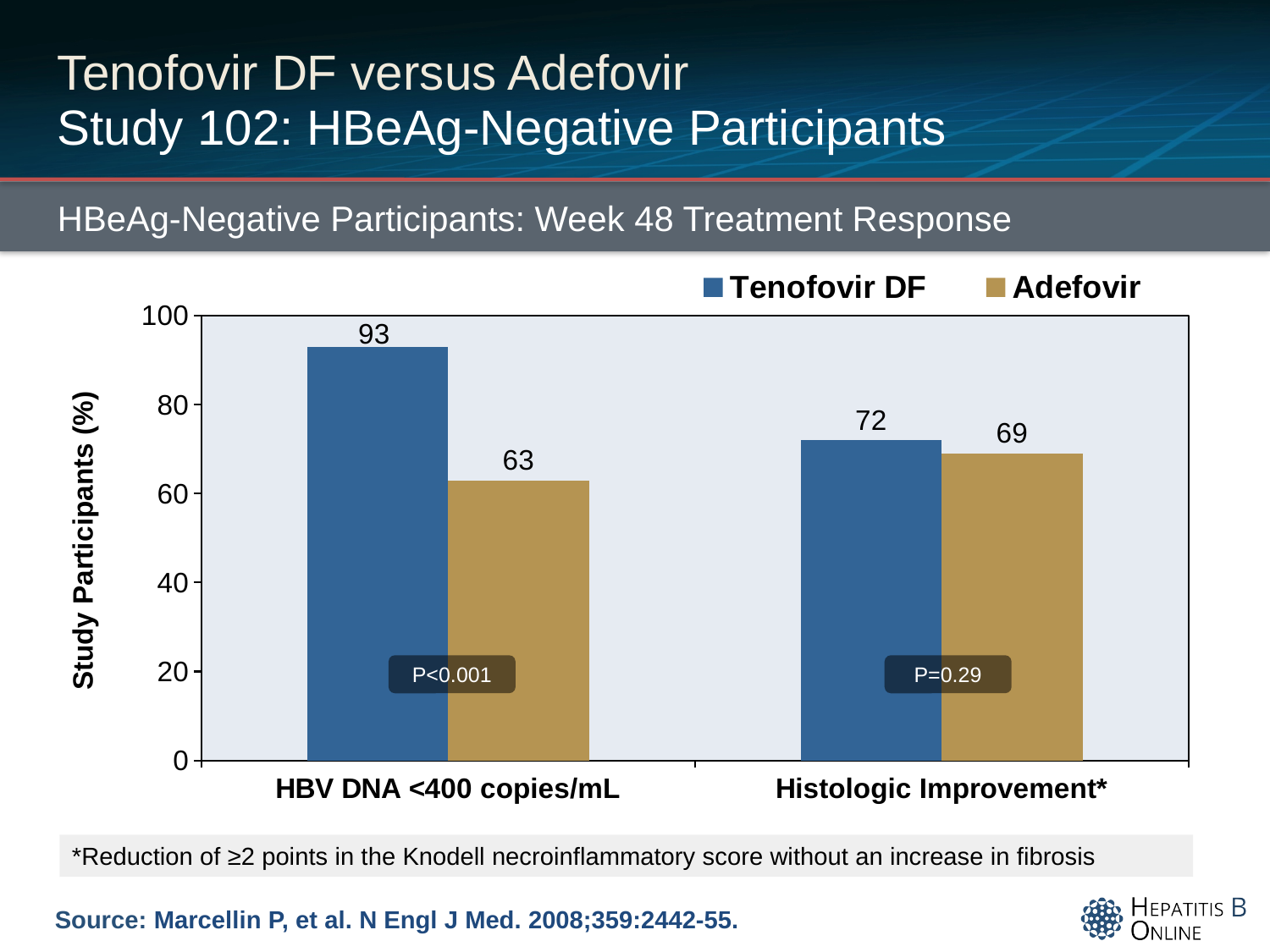
What is the difference between Tenofovir DF and Adefovir for Histologic Improvement*? 3 How many series does the legend list? 2 How many categories are shown on the x axis? 2 What percentage of Tenofovir DF participants achieved HBV DNA <400 copies/mL? 93 What is the value for Adefovir in the Histologic Improvement* category? 69 Which treatment has the larger value for HBV DNA <400 copies/mL, Tenofovir DF or Adefovir? Tenofovir DF What type of chart is shown on the slide? Bar chart What is the value for Tenofovir DF in the Histologic Improvement* category? 72 Which bar has the highest value on the chart? Tenofovir DF, HBV DNA <400 copies/mL What percentage of Adefovir participants achieved HBV DNA <400 copies/mL? 63 Which bar has the lowest value on the chart? Adefovir, HBV DNA <400 copies/mL What is the difference between Tenofovir DF and Adefovir for HBV DNA <400 copies/mL? 30